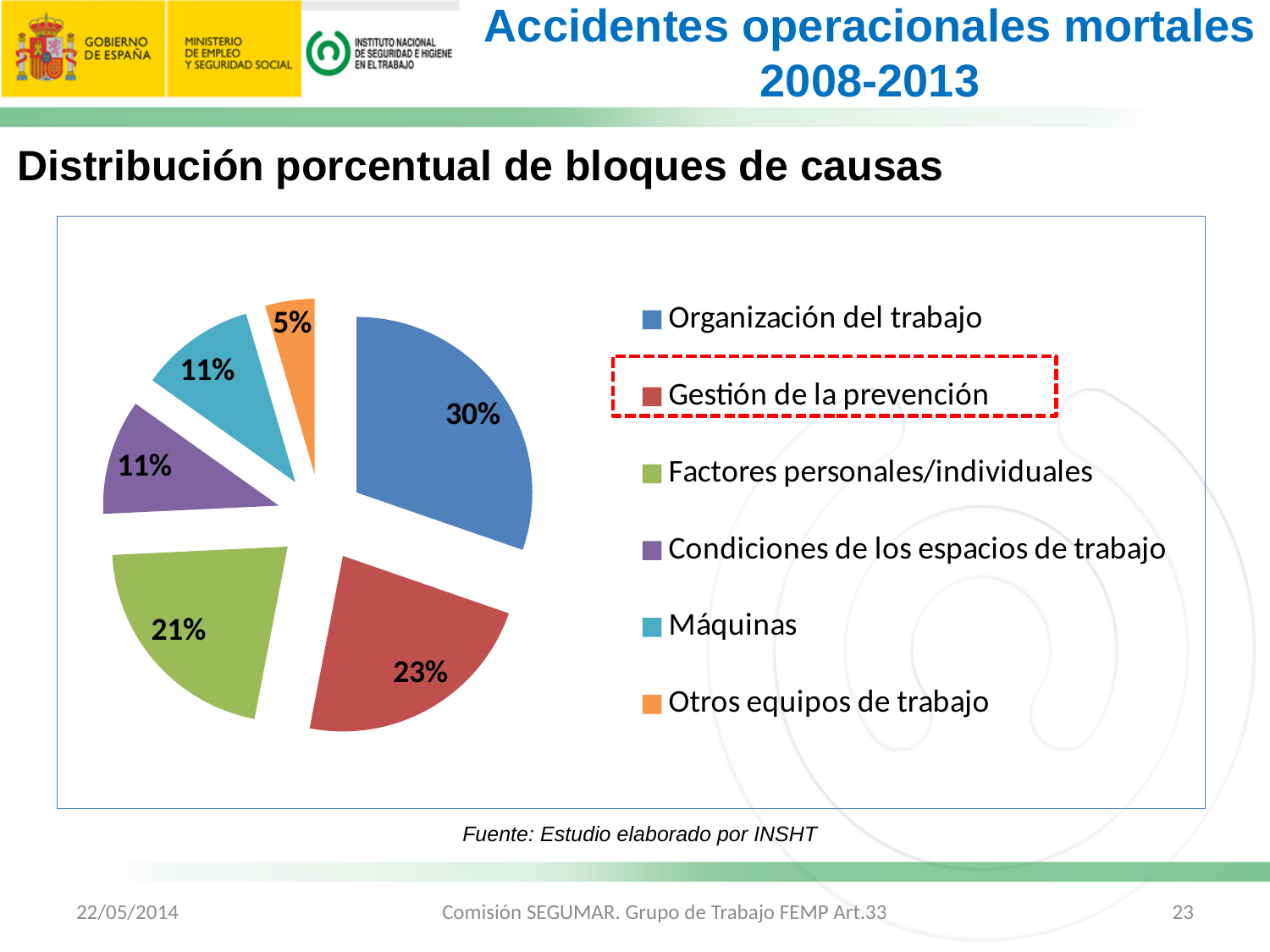
What kind of chart is shown on the slide? pie chart Which category has the largest slice of the pie? Organización del trabajo Which is larger, the share for Factores personales/individuales or the share for Máquinas? Factores personales/individuales What colour is the slice for Máquinas? light blue What share of the pie does Otros equipos de trabajo represent? 5% Which category has the smallest slice of the pie? Otros equipos de trabajo What share of the pie does Organización del trabajo represent? 30% What share of the pie does Gestión de la prevención represent? 23% How many categories does the legend list? 6 What is the difference in percentage points between Organización del trabajo and Gestión de la prevención? 7 Which legend entry is highlighted with a red dashed box? Gestión de la prevención